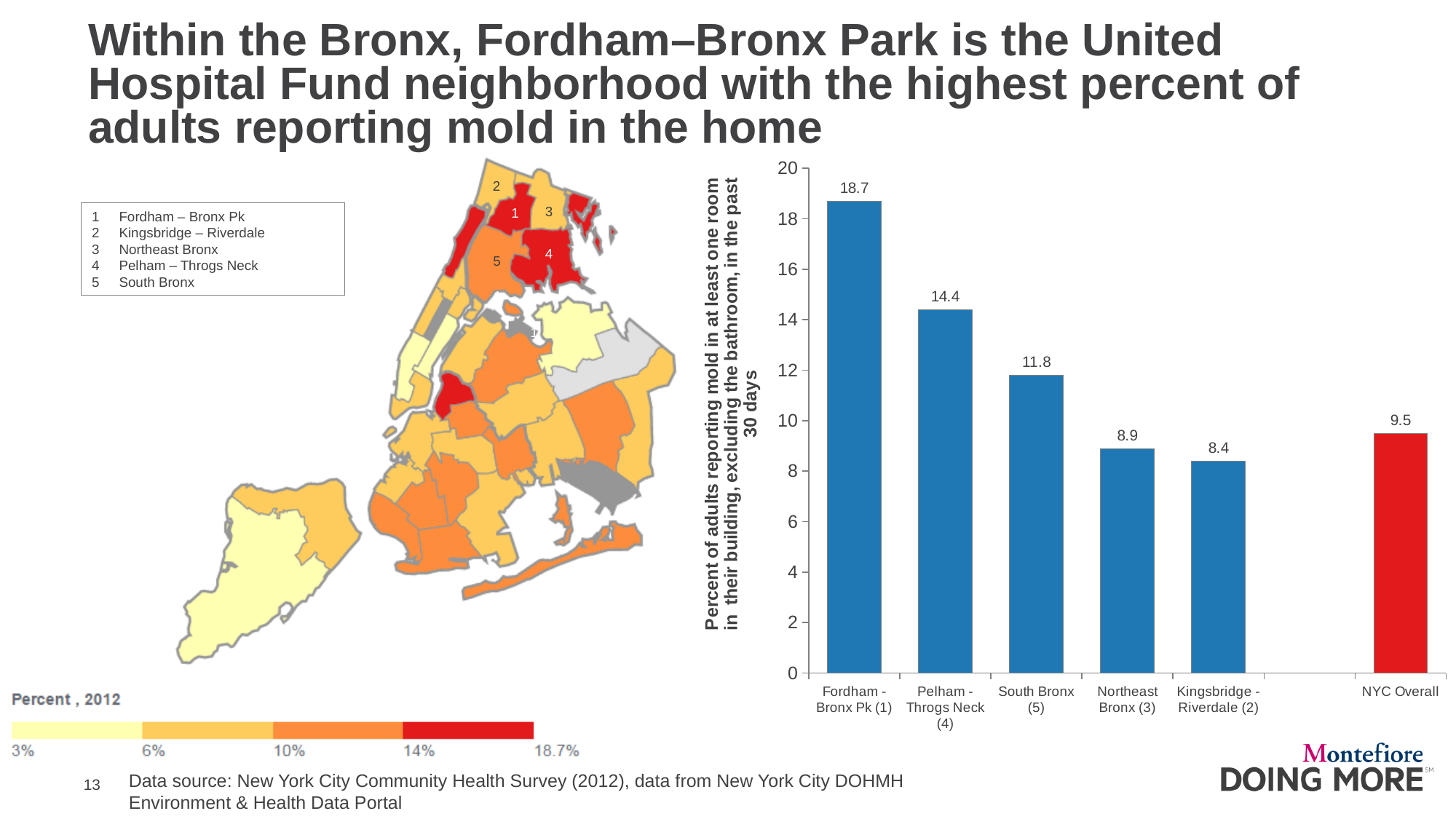
What is the difference between the values for South Bronx (5) and Northeast Bronx (3) in the bar chart? 2.9 What kind of chart is shown on the right side of the slide? Bar chart Which category has the lowest value in the bar chart? Kingsbridge - Riverdale (2) In the bar chart, which bar is colored red rather than blue? NYC Overall What is the value for Kingsbridge - Riverdale (2) in the bar chart? 8.4 What is the value for Fordham - Bronx Pk (1) in the bar chart? 18.7 How many bars are shown in the bar chart? 6 Which category has the highest value in the bar chart? Fordham - Bronx Pk (1) What is the value for NYC Overall in the bar chart? 9.5 What is the difference between the values for Fordham - Bronx Pk (1) and NYC Overall in the bar chart? 9.2 What is the value for Pelham - Throgs Neck (4) in the bar chart? 14.4 In the bar chart, which is larger: the value for Northeast Bronx (3) or the value for NYC Overall? NYC Overall